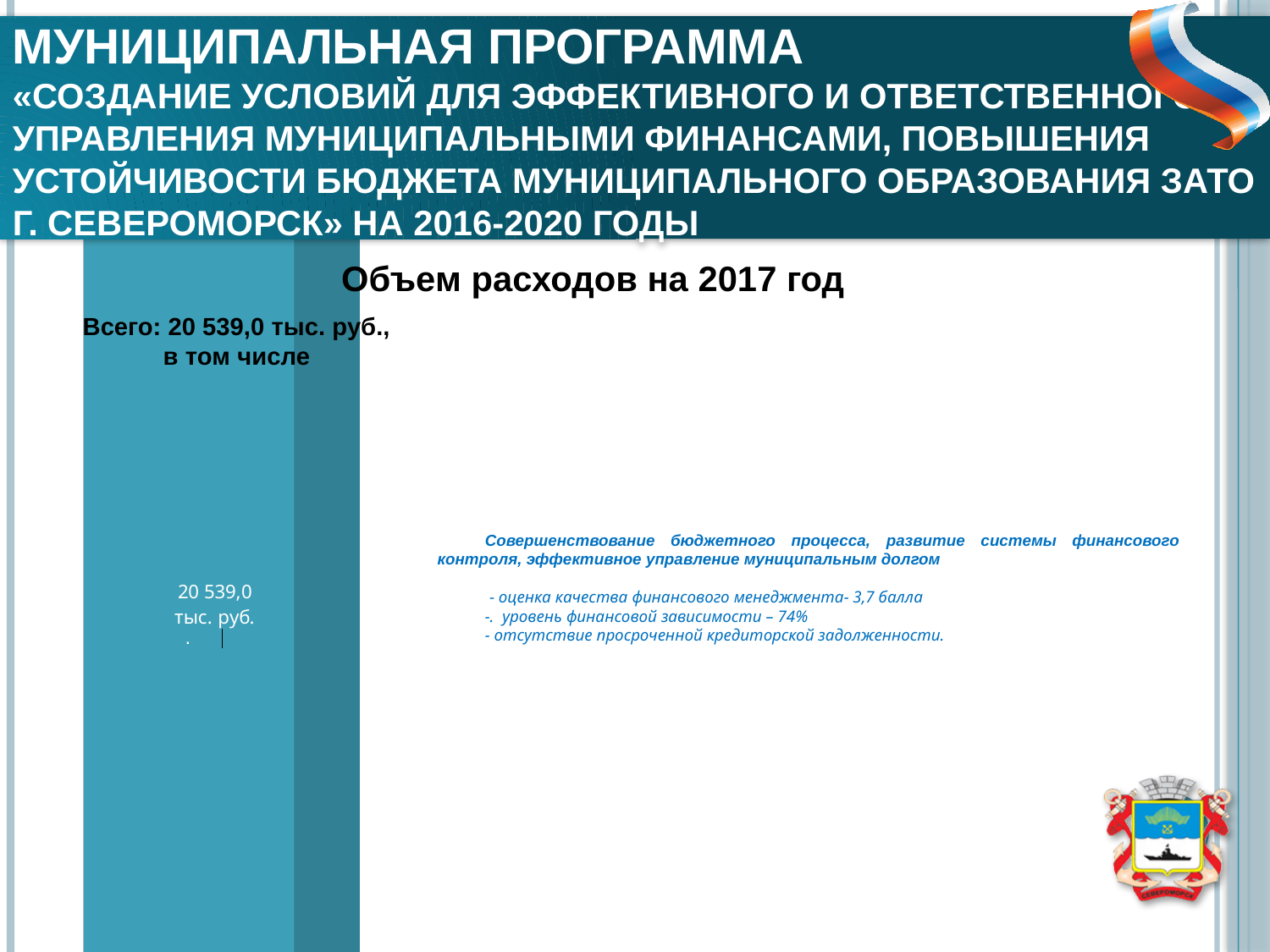
How many bars does the chart contain? 1 Is the value shown on the bar greater or less than 20 000 тыс. руб.? greater What colour is the bar in the chart? teal What total expenditure amount is stated above the chart? 20 539,0 тыс. руб. What value is printed on the bar in the chart? 20 539,0 тыс. руб. What is the title of the chart? Объем расходов на 2017 год What kind of chart is shown on the slide? bar chart